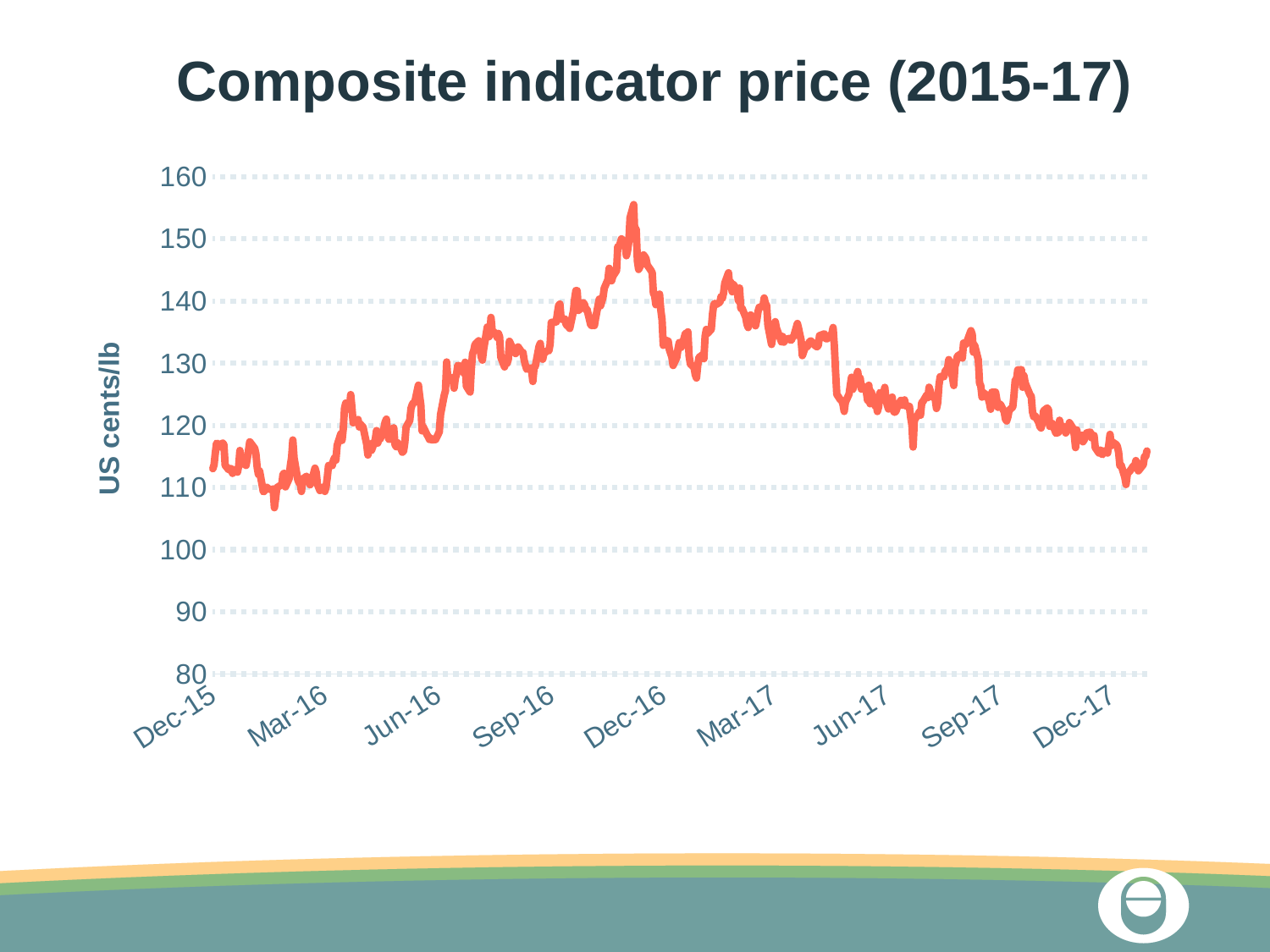
Does the price generally rise or fall between Dec-16 and Dec-17? fall Is the price higher around Dec-16 or around Dec-17? Dec-16 Is the price around Jun-17 greater or less than 130? less What is the title of the chart? Composite indicator price (2015-17) How many lines are plotted on the chart? 1 Is the price at Dec-15 greater or less than 120? less What kind of chart is shown on the slide? line chart Near which labelled month does the price reach its highest point? Dec-16 Is the price around Mar-17 greater or less than 130? greater What unit is shown on the vertical axis label? US cents/lb How many date labels are shown along the x axis? 9